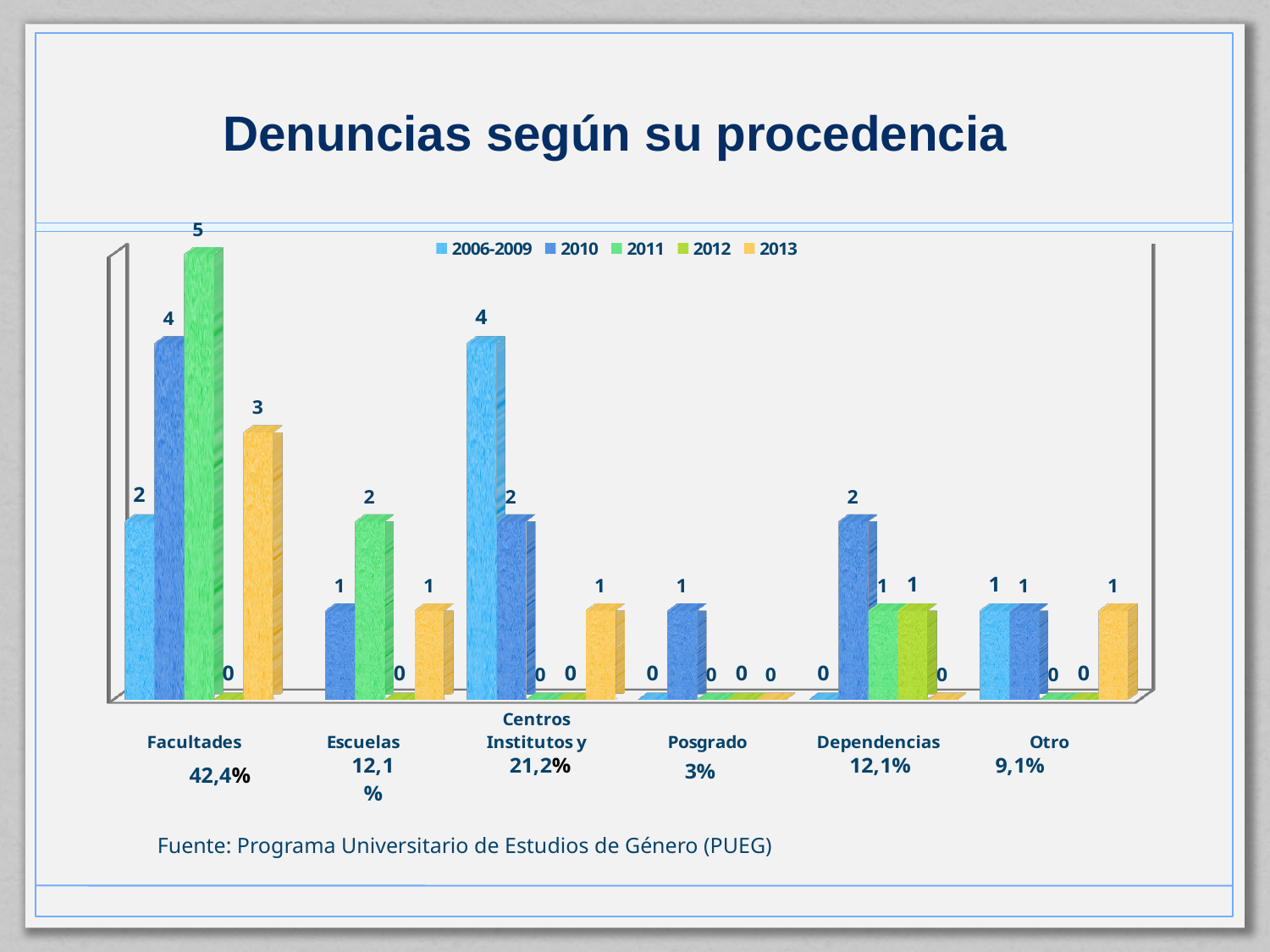
What is the difference between the 2011 value and the 2006-2009 value for Facultades? 3 What kind of chart is shown on the slide? bar chart What is the value for Escuelas in the 2013 series? 1 Which is larger for Centros Institutos y: the 2006-2009 value or the 2010 value? 2006-2009 What is the title of the chart? Denuncias según su procedencia Which category has the highest value in the 2011 series? Facultades What percentage is shown under the Facultades category? 42,4% How many series does the legend list? 5 What is the value for Dependencias in the 2010 series? 2 What is the value for Centros Institutos y in the 2006-2009 series? 4 How many categories are shown on the x axis? 6 What is the value for Facultades in the 2011 series? 5